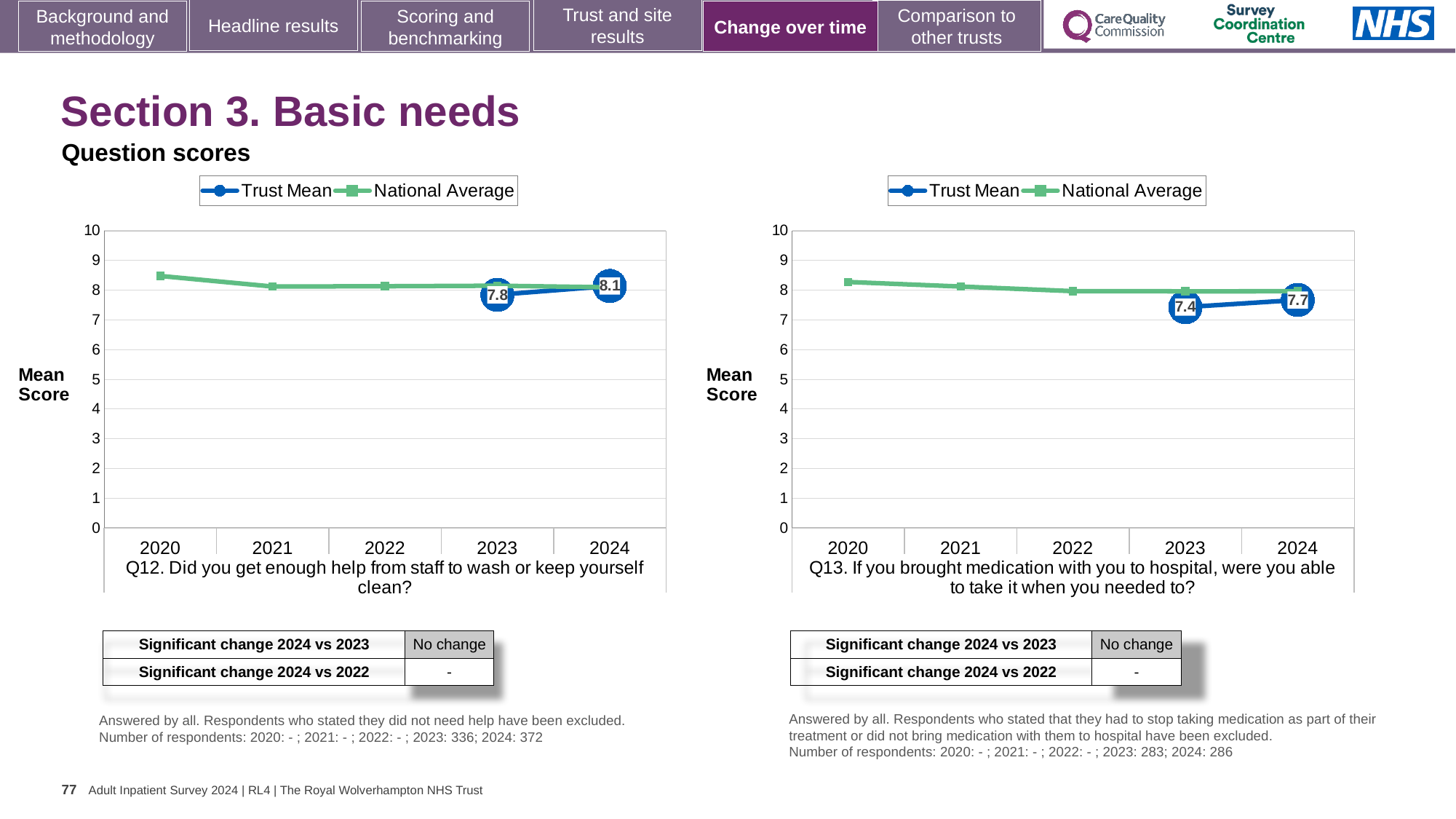
In the Q12 chart (left), by how much did the Trust Mean change from 2023 to 2024? 0.3 In the Q13 chart (right), what is the Trust Mean for 2023? 7.4 In the Q12 chart (left), what is the Trust Mean for 2023? 7.8 In the Q12 chart (left), is the National Average for 2020 greater or less than 8? greater In the Q12 chart (left), does the Trust Mean rise or fall from 2023 to 2024? rise In the Q13 chart (right), what is the Trust Mean for 2024? 7.7 In the Q13 chart (right), is the Trust Mean for 2023 greater or less than 8? less In the Q12 chart (left), what is the Trust Mean for 2024? 8.1 What kind of chart is the Q13 chart (right)? line chart In the Q13 chart (right), what is the difference between the Trust Mean for 2024 and 2023? 0.3 How many years are shown on the x axis of the Q12 chart (left)? 5 How many series does the legend of the Q13 chart (right) list? 2